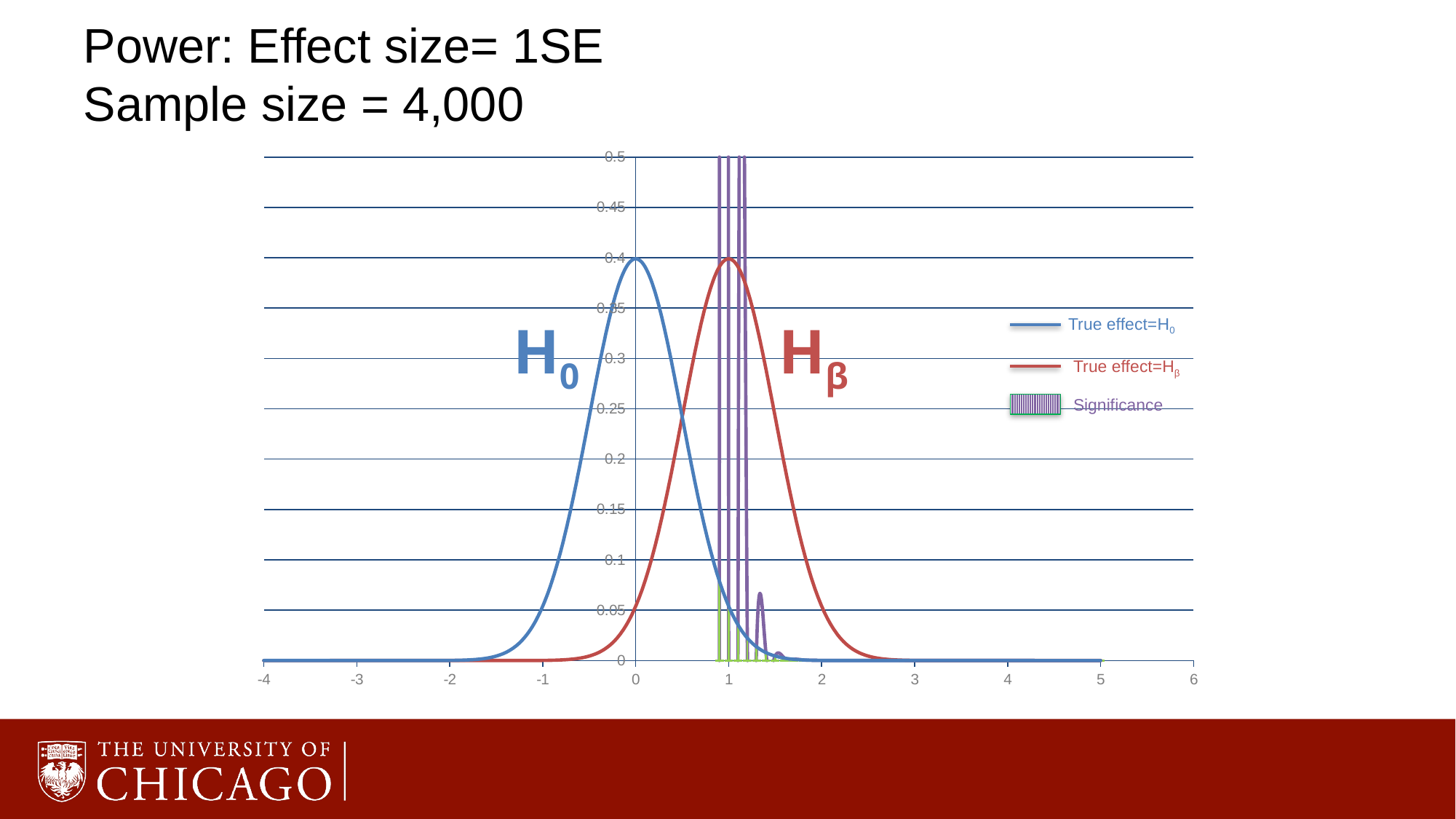
What is the highest value labelled on the y axis? 0.5 What kind of chart is shown on the slide? line chart Is the peak of the blue True effect=H0 curve greater or less than 0.35? greater Is the value of the blue True effect=H0 curve at x = 1 greater or less than 0.3? less At x = 0, which curve is higher, the blue True effect=H0 curve or the red True effect=Hβ curve? True effect=H0 What is the label of the purple hatched series in the legend? Significance Which series is drawn in red according to the legend? True effect=Hβ Does the red True effect=Hβ curve rise or fall as x goes from -1 to 1? rise At x = 1, which curve is higher, the blue True effect=H0 curve or the red True effect=Hβ curve? True effect=Hβ Is the peak of the red True effect=Hβ curve greater or less than 0.45? less Does the blue True effect=H0 curve rise or fall as x goes from 0 to 2? fall How many series does the legend list? 3